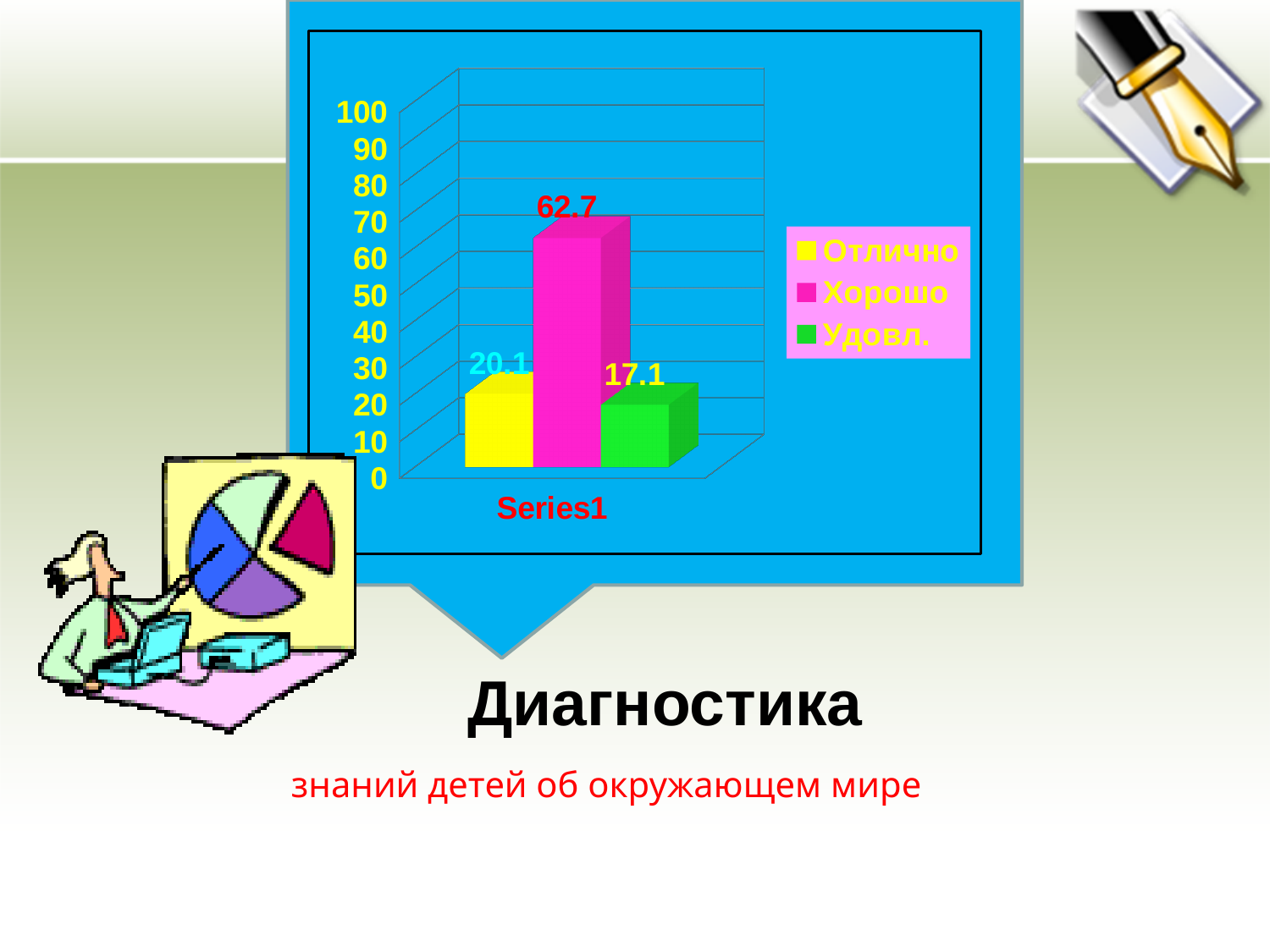
Is the value for Хорошо greater or less than 50? greater What is the value for Хорошо? 62.7 How many entries does the legend list? 3 How many bars are plotted in the chart? 3 What is the difference between the values for Хорошо and Отлично? 42.6 What kind of chart is shown on the slide? bar chart What is the value for Удовл.? 17.1 Which is larger, the value for Хорошо or the value for Удовл.? Хорошо Which category has the highest value? Хорошо What is the value for Отлично? 20.1 Which category has the lowest value? Удовл. What is the difference between the values for Отлично and Удовл.? 3.0